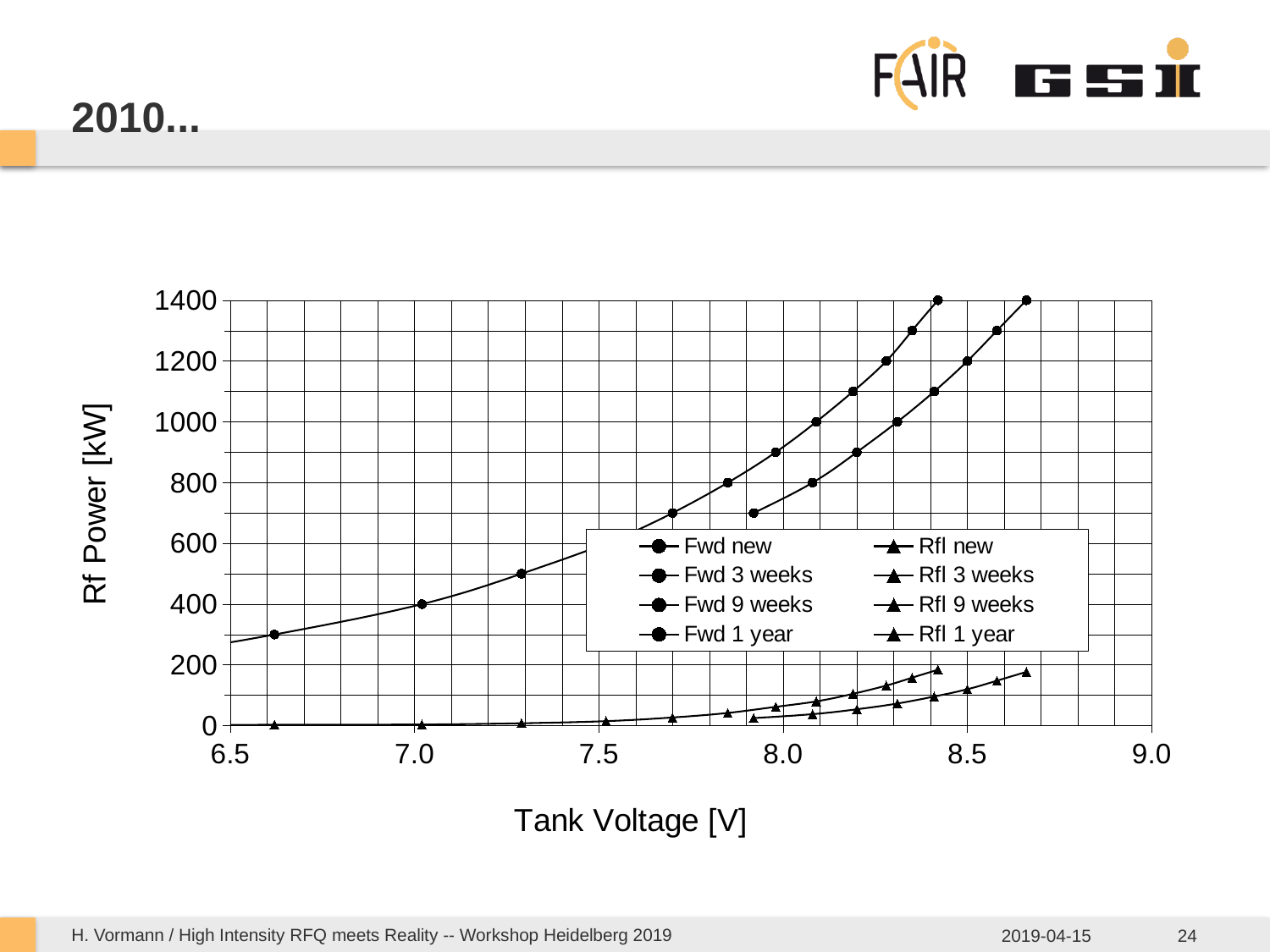
Do the Rfl series rise or fall as Tank Voltage increases? rise How many series does the legend list? 8 Is the highest plotted Fwd value greater or less than 1200 kW? greater What kind of chart is shown on the slide? line chart What is the label of the y axis? Rf Power [kW] At a Tank Voltage of 8.0 V, are the Fwd series or the Rfl series higher in Rf Power? Fwd What is the label of the x axis? Tank Voltage [V] What is the highest tick value shown on the Rf Power axis? 1400 Do the Fwd series rise or fall as Tank Voltage increases? rise Are the values of the Rfl series greater or less than 400 kW across the whole plotted range? less